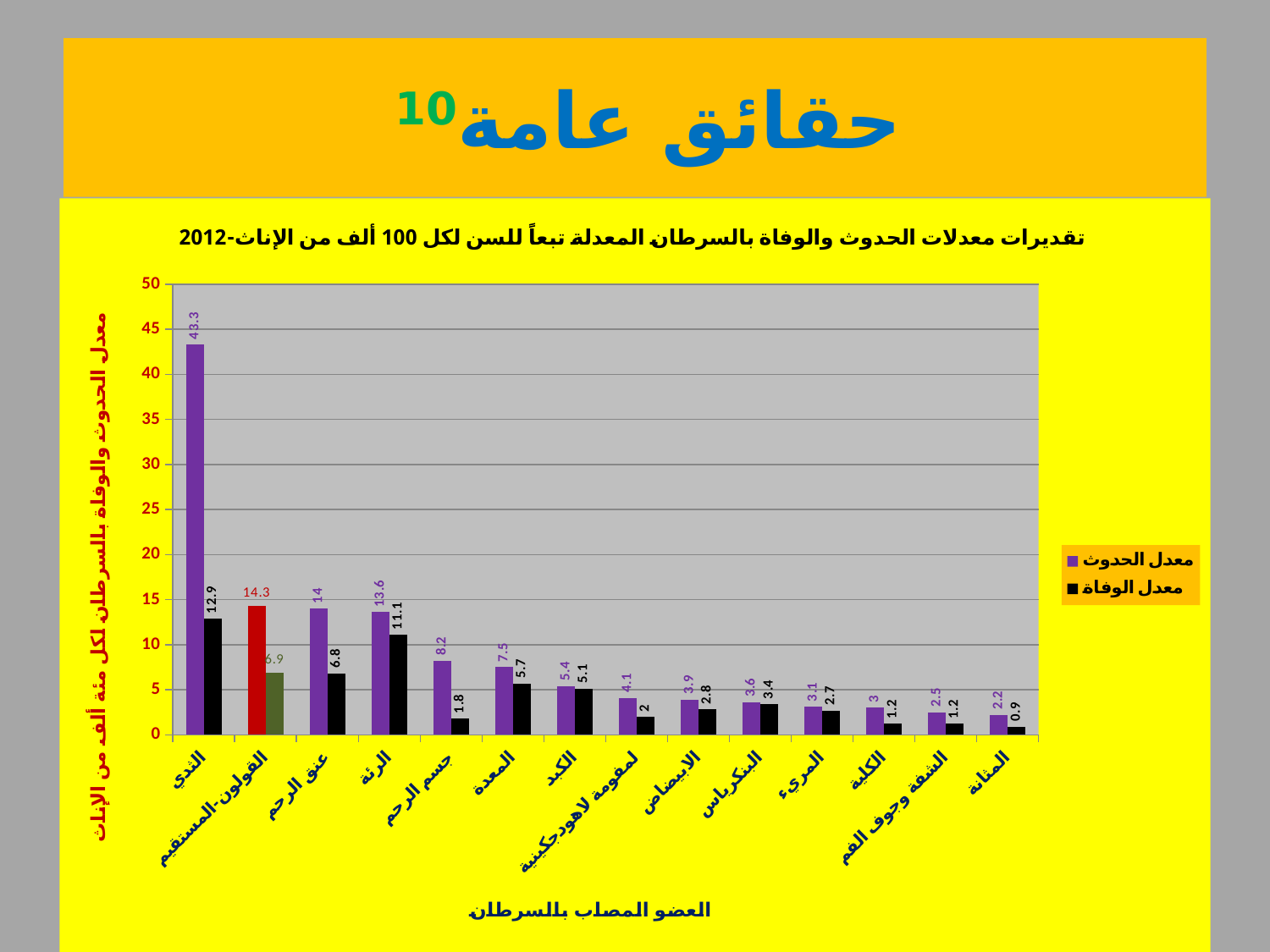
What type of chart is shown on the slide? bar chart Do the incidence rate (معدل الحدوث) values rise or fall moving from left to right along the x axis? fall How many series does the legend list? 2 Which cancer site has the lowest mortality rate (معدل الوفاة)? المثانة What is the incidence rate (معدل الحدوث) for colon-rectum cancer (القولون-المستقيم)? 14.3 Which cancer site has the highest incidence rate (معدل الحدوث)? الثدي How many cancer sites (categories) are shown on the x axis? 14 What colour are the bars for the mortality rate series (معدل الوفاة) in the legend? black What is the mortality rate (معدل الوفاة) for lung cancer (الرئة)? 11.1 What is the difference between the incidence rate and the mortality rate for breast cancer (الثدي)? 30.4 What is the incidence rate (معدل الحدوث) for breast cancer (الثدي)? 43.3 Which is larger: the mortality rate for lung cancer (الرئة) or the mortality rate for cervical cancer (عنق الرحم)? الرئة